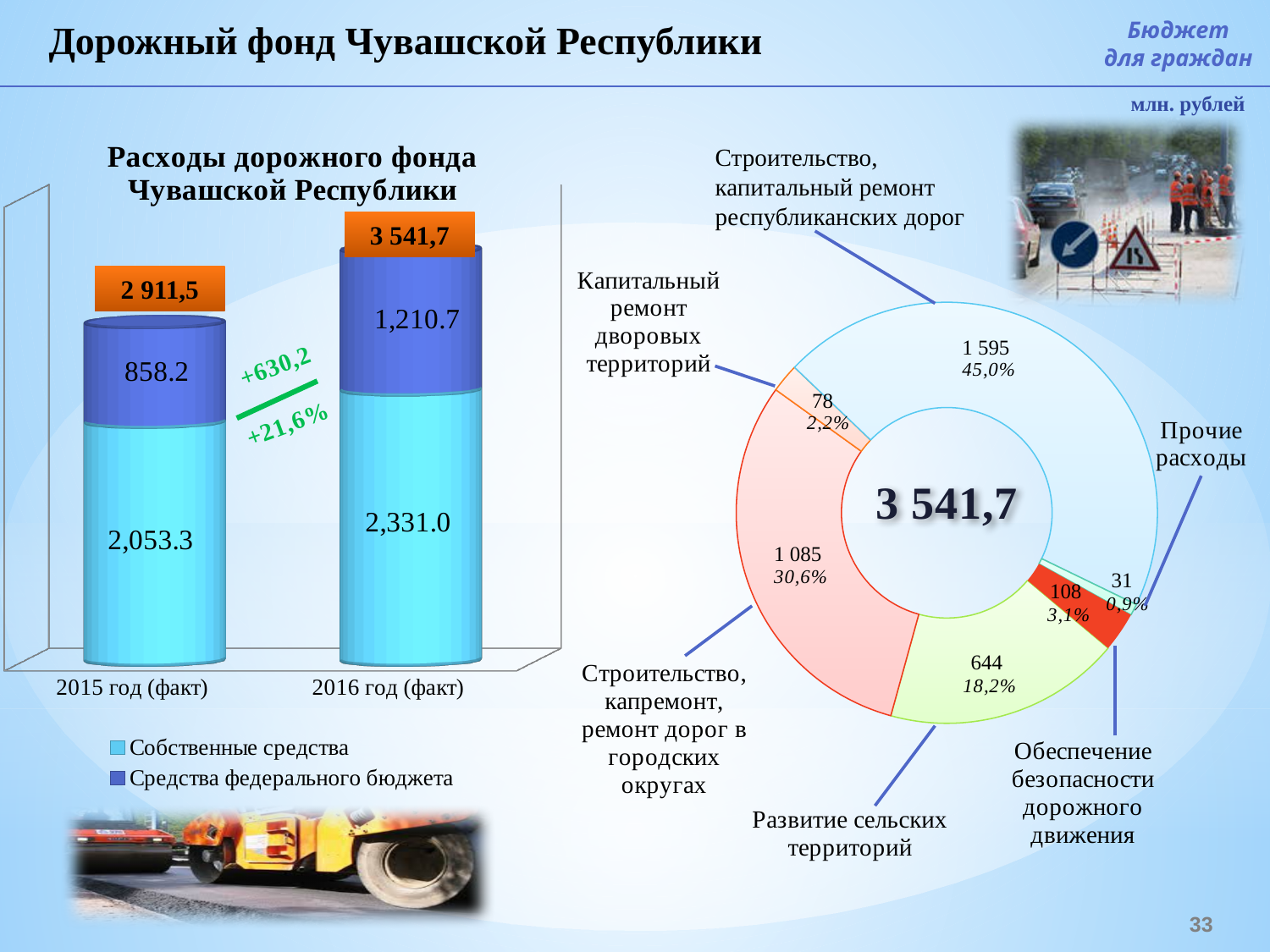
In the donut chart on the right, which category has the smallest value? Прочие расходы In the bar chart «Расходы дорожного фонда Чувашской Республики», what is the total shown for 2015 год (факт)? 2 911,5 In the bar chart «Расходы дорожного фонда Чувашской Республики», what is the difference between «Собственные средства» in 2016 and in 2015? 277.7 In the bar chart «Расходы дорожного фонда Чувашской Республики», how many series does the legend list? 2 In the bar chart «Расходы дорожного фонда Чувашской Республики», what is the value of «Средства федерального бюджета» for 2015 год (факт)? 858.2 In the donut chart on the right, what is the value for «Развитие сельских территорий»? 644 In the bar chart «Расходы дорожного фонда Чувашской Республики», what is the value of «Собственные средства» for 2016 год (факт)? 2,331.0 In the bar chart «Расходы дорожного фонда Чувашской Республики», what kind of chart is it? Stacked bar chart In the donut chart on the right, how many categories are shown? 6 In the bar chart «Расходы дорожного фонда Чувашской Республики», which year has the larger value for «Средства федерального бюджета»? 2016 год (факт) In the bar chart «Расходы дорожного фонда Чувашской Республики», what is the total shown for 2016 год (факт)? 3 541,7 In the donut chart on the right, what share does «Строительство, капитальный ремонт республиканских дорог» have? 45,0%